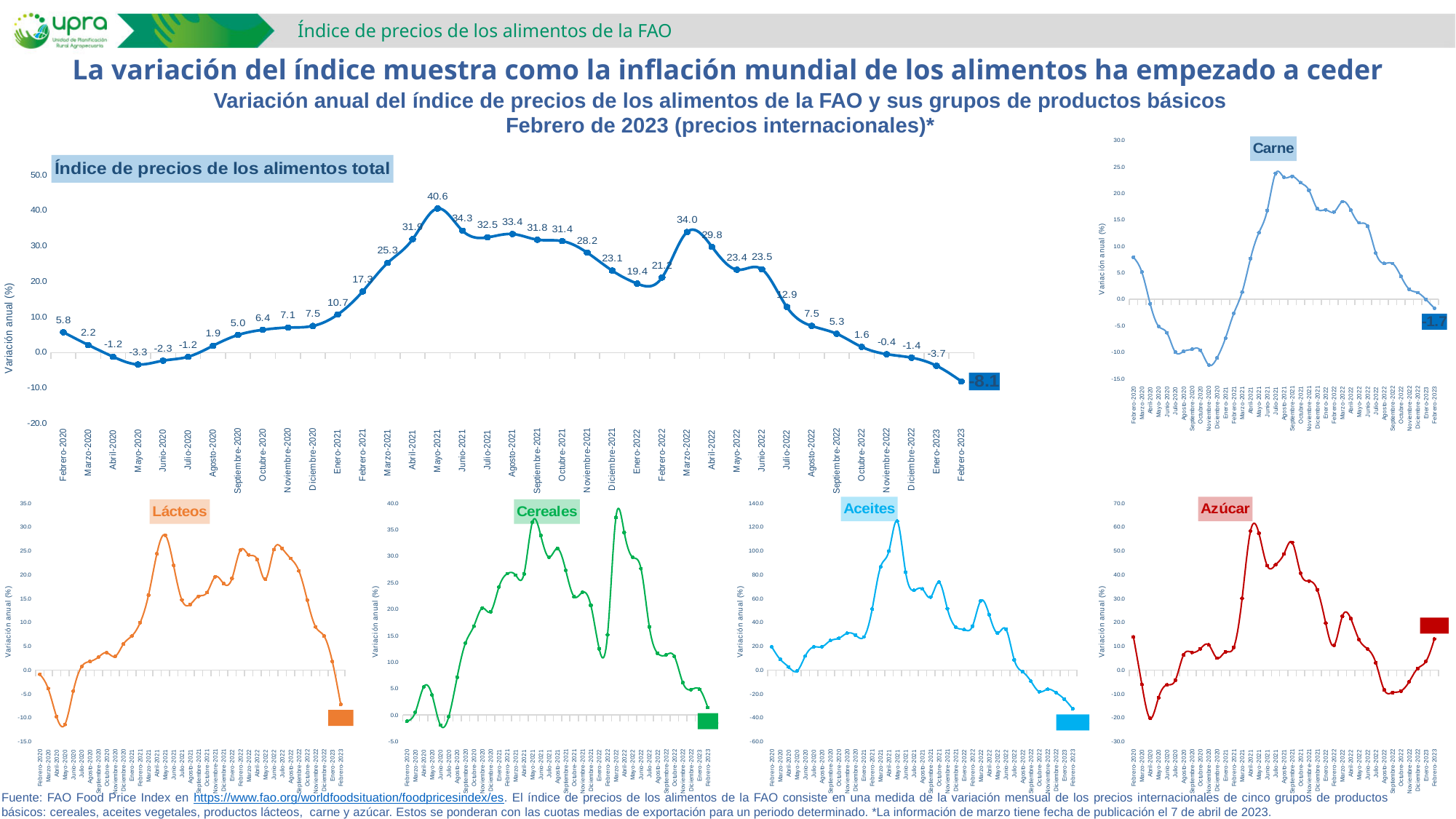
On the 'Índice de precios de los alimentos total' chart, what is the value for Febrero-2023? -8.1 On the 'Índice de precios de los alimentos total' chart, which month has the lowest value? Febrero-2023 On the 'Índice de precios de los alimentos total' chart, what is the value for Marzo-2022? 34.0 On the 'Índice de precios de los alimentos total' chart, which is larger, the value for Febrero-2021 or the value for Marzo-2021? Marzo-2021 On the 'Índice de precios de los alimentos total' chart, which month has the highest value? Mayo-2021 On the 'Azúcar' chart, is the value for Abril-2021 greater or less than 50? greater On the 'Carne' chart, what is the value for Febrero-2023? -1.7 On the 'Índice de precios de los alimentos total' chart, what is the value for Mayo-2021? 40.6 What kind of chart is the 'Cereales' chart? line chart On the 'Índice de precios de los alimentos total' chart, what is the difference between the values for Mayo-2021 and Junio-2021? 6.3 On the 'Índice de precios de los alimentos total' chart, do the values rise or fall from Julio-2022 to Febrero-2023? fall